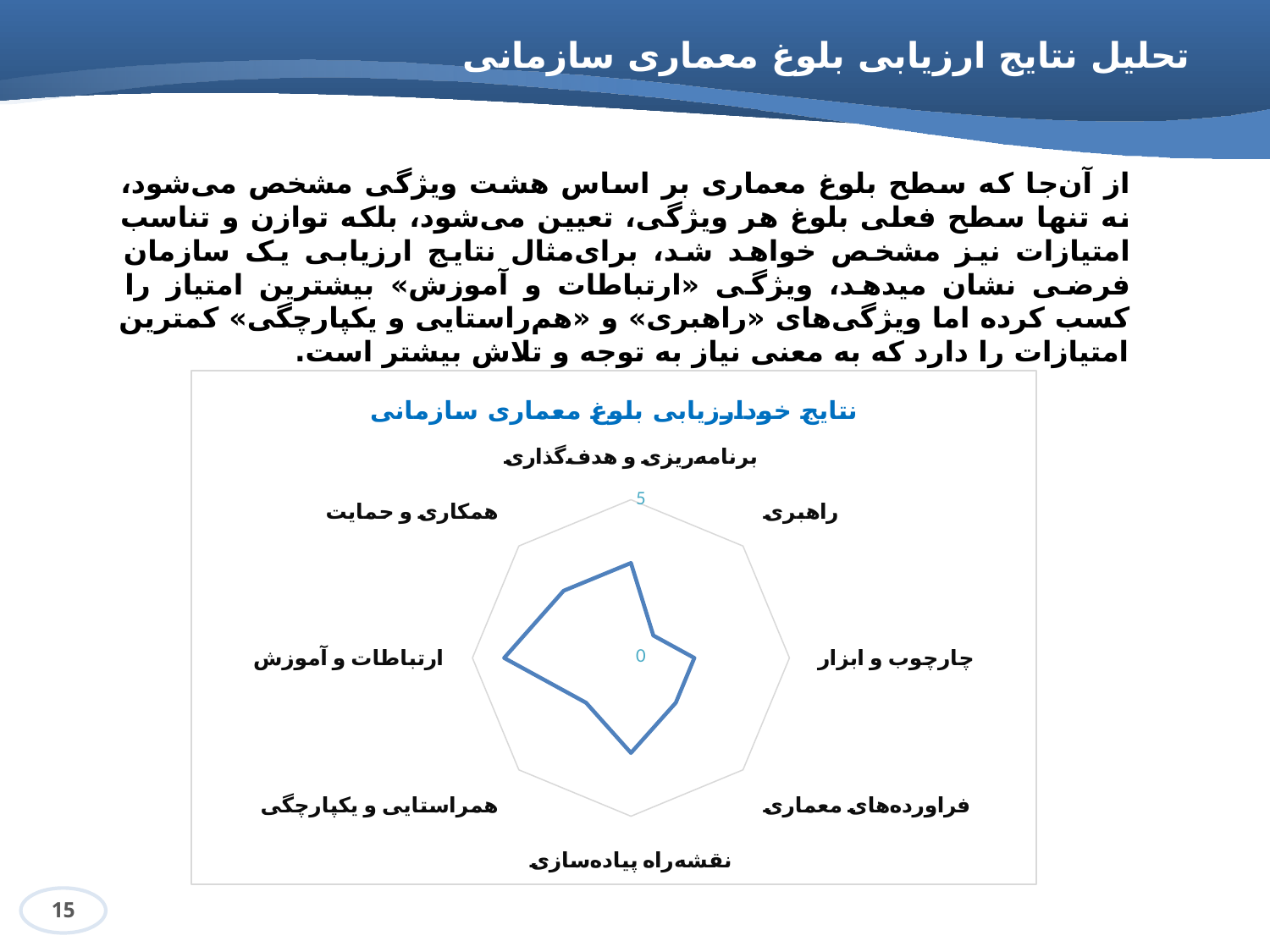
Which is larger, the value for برنامه‌ریزی و هدف‌گذاری or the value for چارچوب و ابزار? برنامه‌ریزی و هدف‌گذاری Which category has the highest value in the chart? ارتباطات و آموزش What kind of chart is shown on the slide? Radar chart Which is larger, the value for ارتباطات و آموزش or the value for راهبری? ارتباطات و آموزش What is the maximum value shown on the chart's axis scale? 5 Which is larger, the value for ارتباطات و آموزش or the value for همکاری و حمایت? ارتباطات و آموزش What is the title of the chart? نتایج خودارزیابی بلوغ معماری سازمانی How many categories (axes) does the radar chart have? 8 Is the value for ارتباطات و آموزش greater or less than 5? less